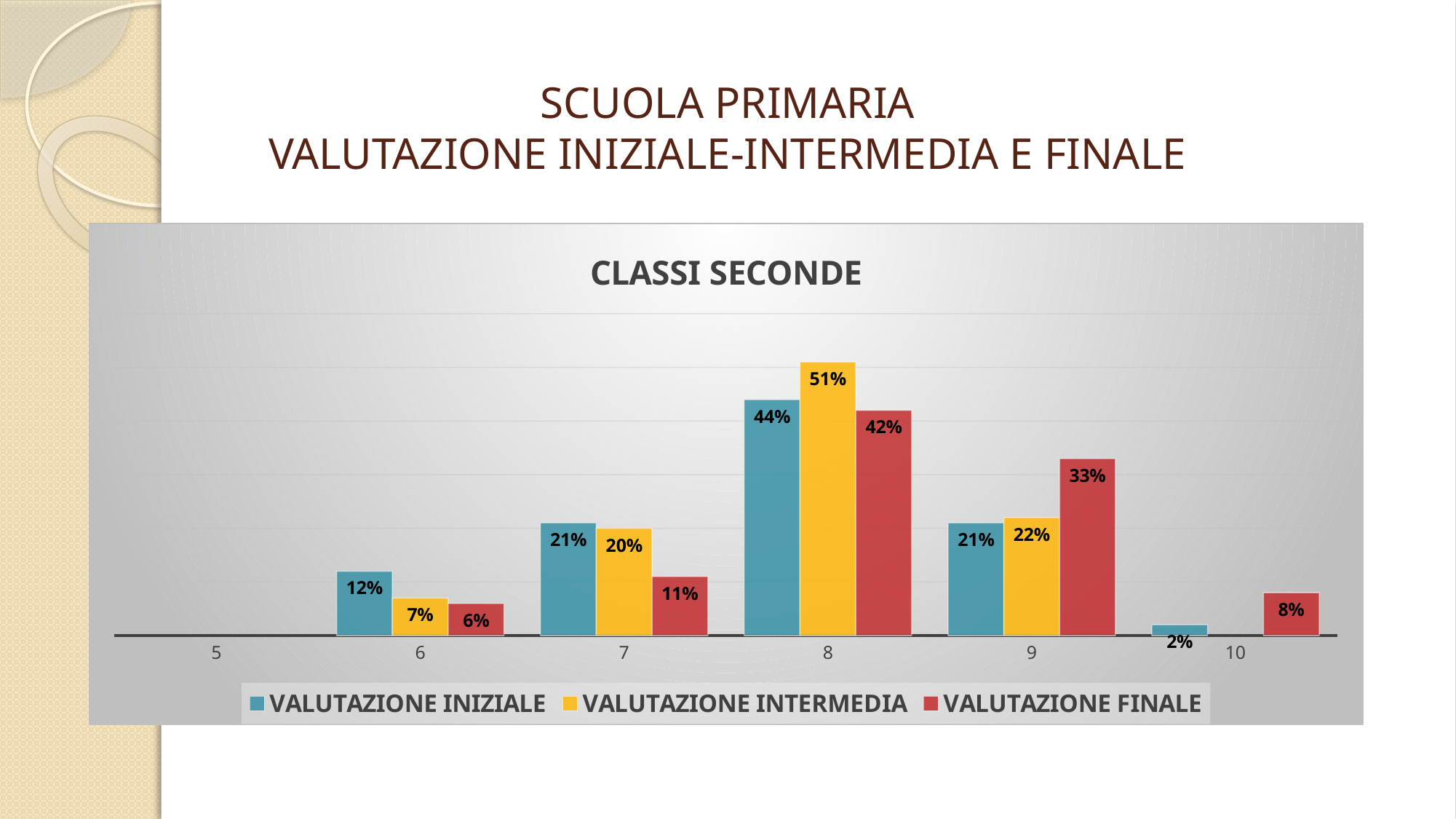
What is the difference between the VALUTAZIONE INTERMEDIA and VALUTAZIONE INIZIALE values for category 8? 7% What is the VALUTAZIONE INTERMEDIA value for category 8? 51% Which category has the lowest VALUTAZIONE FINALE value? 6 Which category has the highest VALUTAZIONE INIZIALE value? 8 What is the VALUTAZIONE INIZIALE value for category 6? 12% What is the VALUTAZIONE FINALE value for category 9? 33% How many categories are shown on the x axis? 6 What is the VALUTAZIONE FINALE value for category 10? 8% What kind of chart is shown on the slide? Bar chart How many series does the legend list? 3 What is the title of the chart? CLASSI SECONDE For category 9, which is larger: VALUTAZIONE INIZIALE or VALUTAZIONE FINALE? VALUTAZIONE FINALE